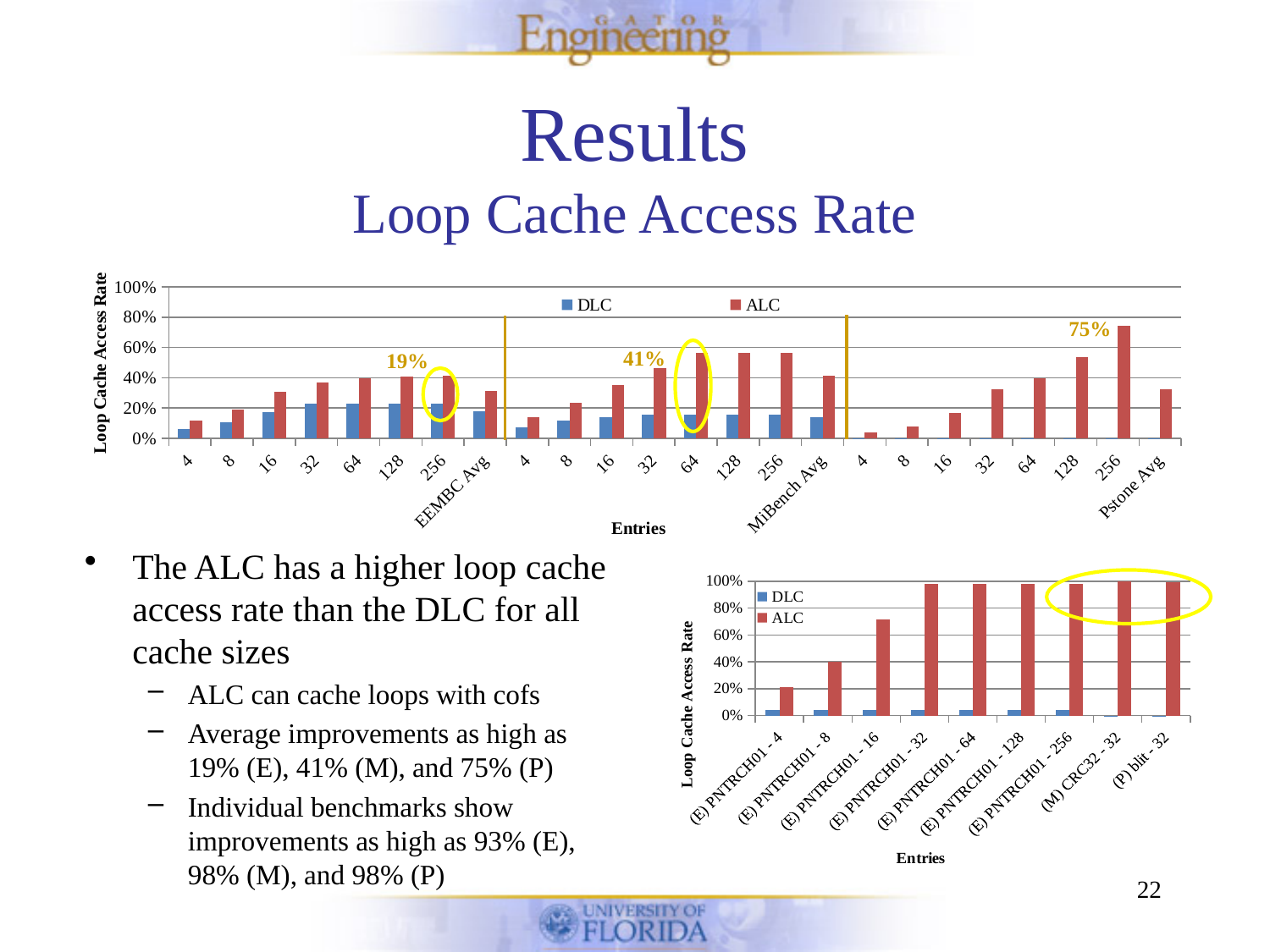
In the bottom-right chart, is the ALC value for (E) PNTRCH01 - 16 greater or less than 60%? greater What kind of chart is the top chart on the slide? bar chart How many series does the legend of the top chart list? 2 In the top chart, which category has the highest ALC value? Pstone 256 In the top chart, which is larger for EEMBC 256 entries, the DLC value or the ALC value? ALC In the top chart, is the ALC value for EEMBC 4 entries greater or less than 20%? less What is the x-axis title of the top chart? Entries In the bottom-right chart, do the ALC values rise or fall as the (E) PNTRCH01 entries increase from 4 to 256? rise What are the two series named in the legend of the top chart? DLC and ALC In the top chart, is the ALC value for Pstone 256 entries greater or less than 60%? greater How many categories are shown on the x axis of the bottom-right chart? 9